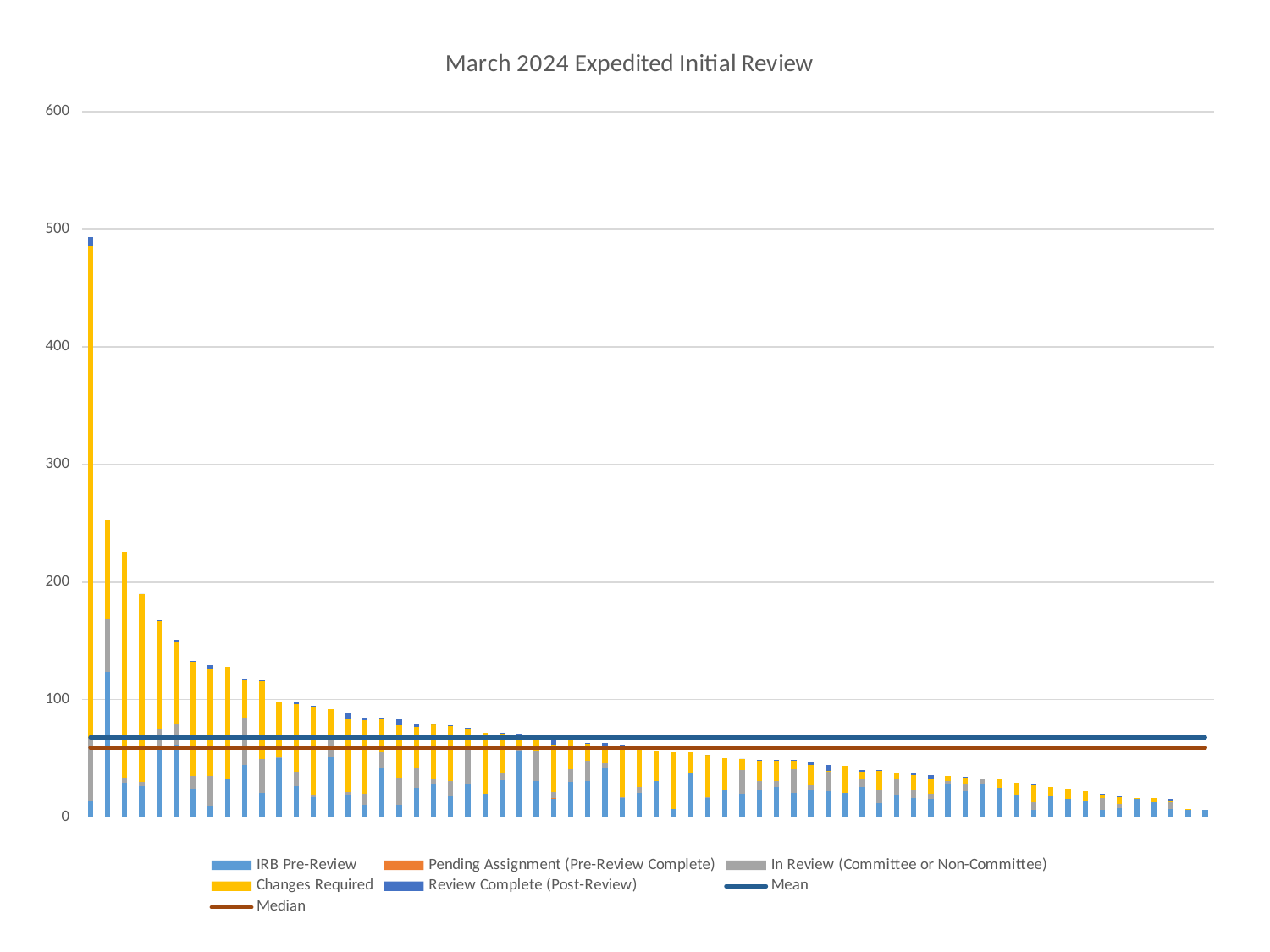
Which series makes up the largest portion of the tallest (leftmost) bar? Changes Required What is the title of the chart? March 2024 Expedited Initial Review Which horizontal reference line is higher on the chart, Mean or Median? Mean What kind of chart is shown on the slide? Stacked bar chart with Mean and Median lines (combination bar and line chart) Do the bar totals rise or fall moving from left to right along the x axis? Fall How many entries does the chart's legend list? 7 Is the total of the tallest (leftmost) bar greater or less than 400? greater Is the total of the rightmost bar greater or less than 100? less Is the total of the second bar from the left greater or less than 300? less